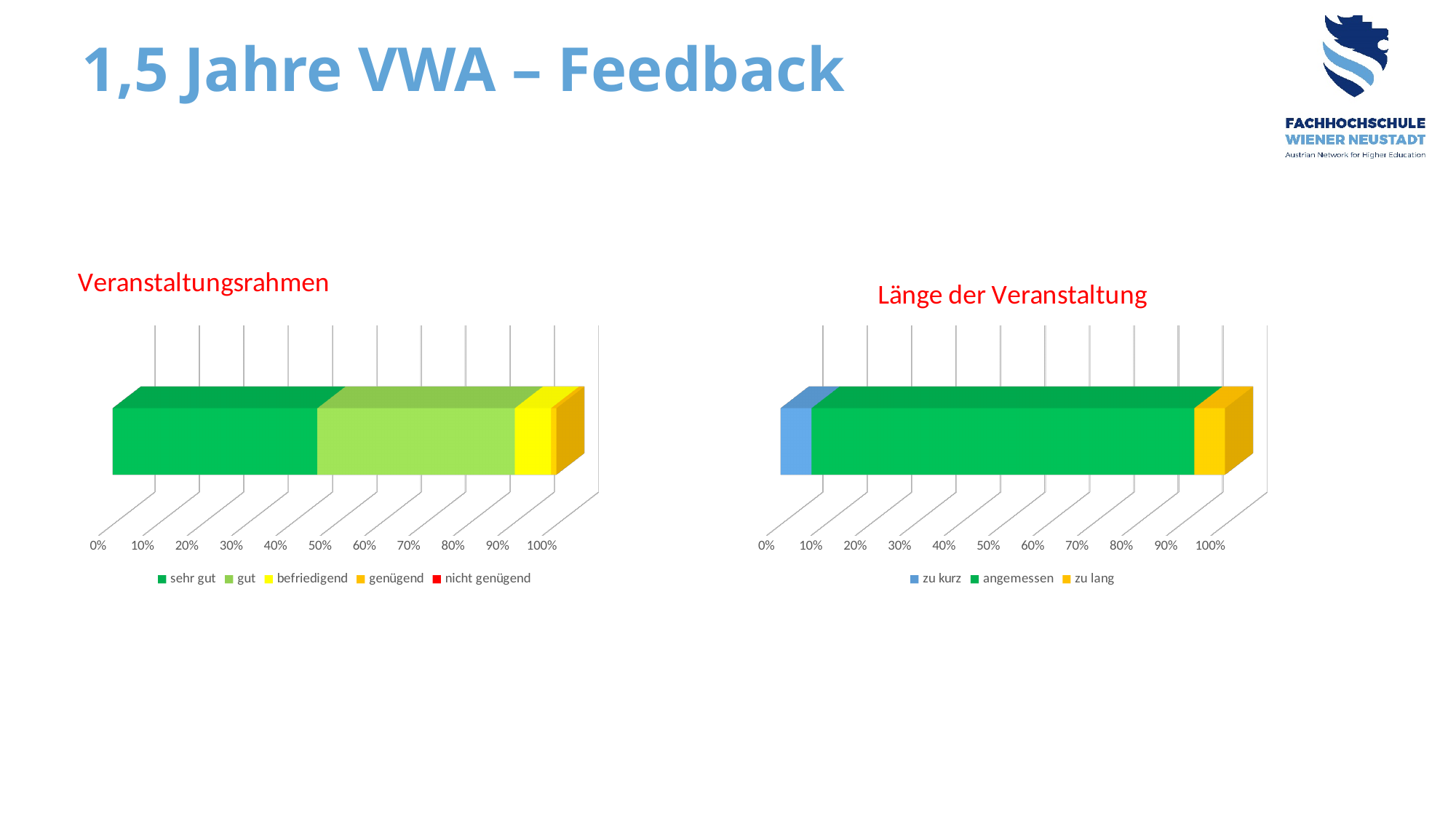
What kind of chart is the "Veranstaltungsrahmen" chart? bar chart In the "Länge der Veranstaltung" chart, which category has the largest share? angemessen In the "Veranstaltungsrahmen" chart, which is larger, the share for "sehr gut" or for "befriedigend"? sehr gut In the "Veranstaltungsrahmen" chart, is the share for "sehr gut" greater or less than 30%? greater In the "Länge der Veranstaltung" chart, which colour represents "zu kurz" in the legend? blue How many series does the legend of the "Länge der Veranstaltung" chart list? 3 In the "Veranstaltungsrahmen" chart, is the share for "befriedigend" greater or less than 20%? less In the "Länge der Veranstaltung" chart, which is larger, the share for "angemessen" or for "zu lang"? angemessen What is the title of the chart on the right side of the slide? Länge der Veranstaltung In the "Länge der Veranstaltung" chart, is the share for "zu kurz" greater or less than 20%? less How many series does the legend of the "Veranstaltungsrahmen" chart list? 5